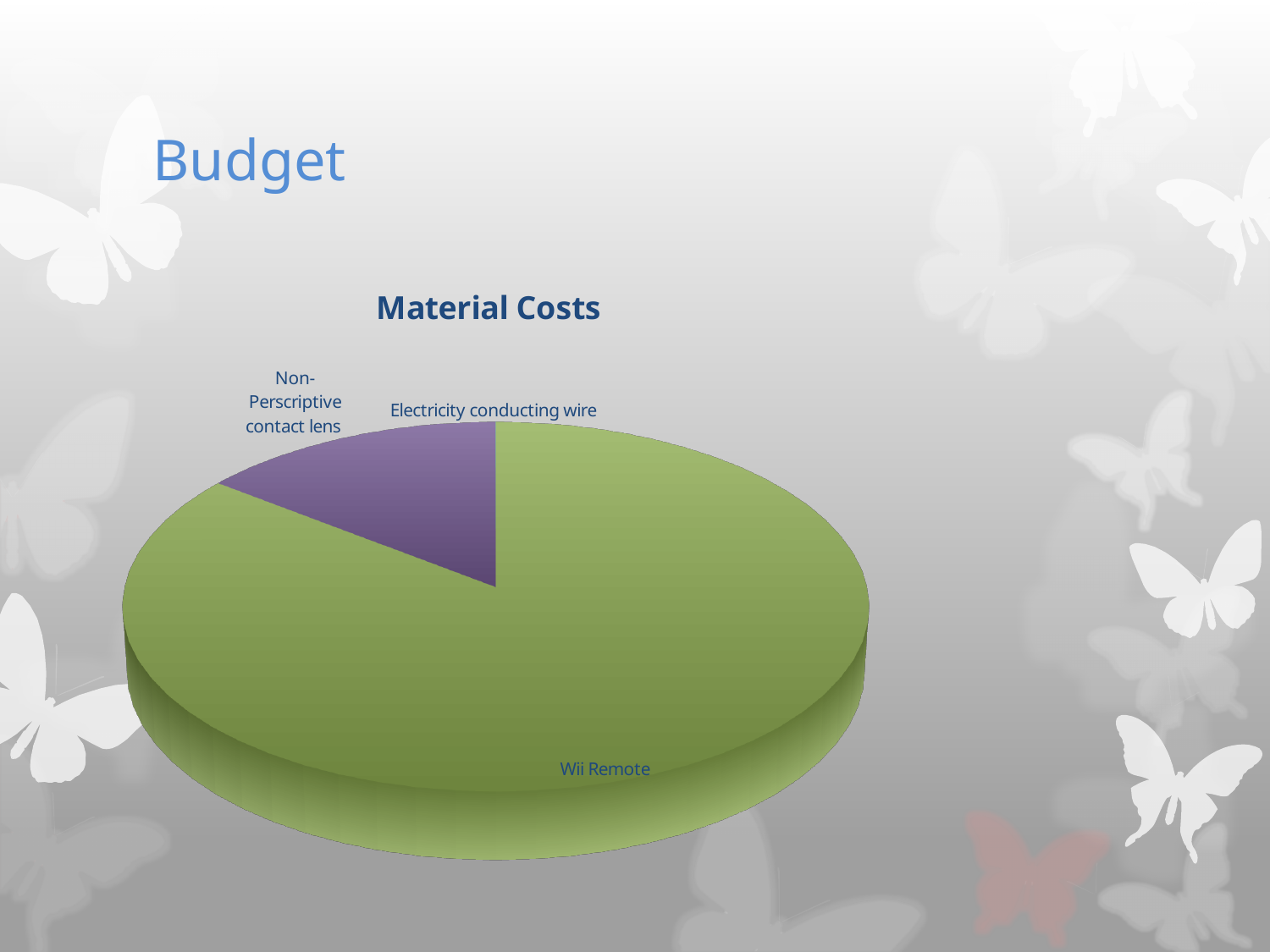
Which category is shown by the purple slice? Non-Perscriptive contact lens How many categories are labelled on the pie chart? 3 What is the title of the chart? Material Costs What kind of chart is shown on the slide? pie chart What colour is the Wii Remote slice? green Which category has the largest slice of the pie? Wii Remote Which is larger, the slice for Wii Remote or the slice for Non-Perscriptive contact lens? Wii Remote